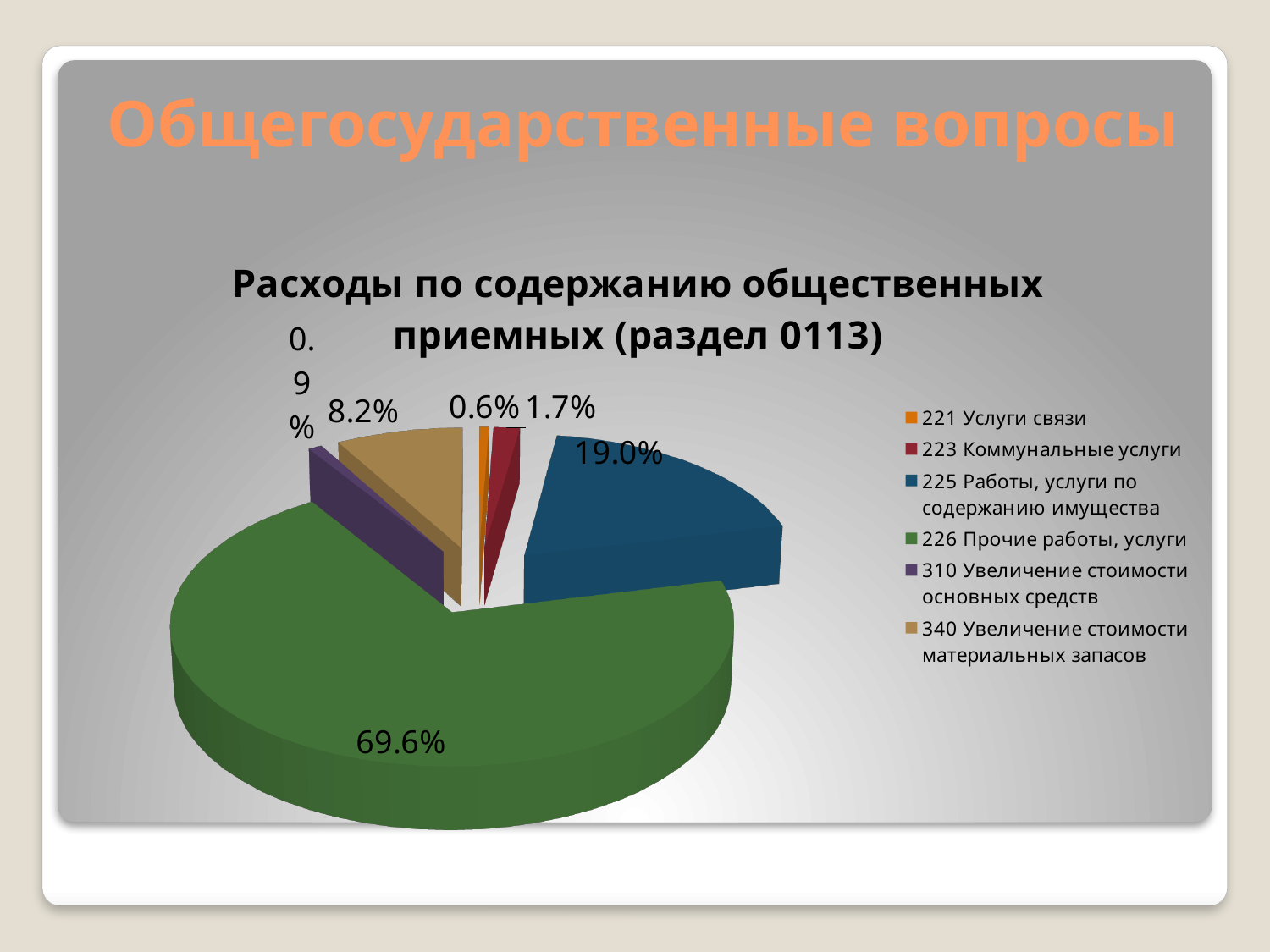
What is the share for 223 Коммунальные услуги? 1.7% How many categories does the legend list? 6 What is the share for 340 Увеличение стоимости материальных запасов? 8.2% What is the share for 225 Работы, услуги по содержанию имущества? 19.0% What is the title of the chart? Расходы по содержанию общественных приемных (раздел 0113) Which category has the smallest share of the pie? 221 Услуги связи What is the difference between the shares of 226 Прочие работы, услуги and 225 Работы, услуги по содержанию имущества? 50.6% Which category has the largest share of the pie? 226 Прочие работы, услуги What is the share for 226 Прочие работы, услуги? 69.6% What kind of chart is shown on the slide? pie chart What is the share for 221 Услуги связи? 0.6% Which is larger: the share for 340 Увеличение стоимости материальных запасов or the share for 223 Коммунальные услуги? 340 Увеличение стоимости материальных запасов